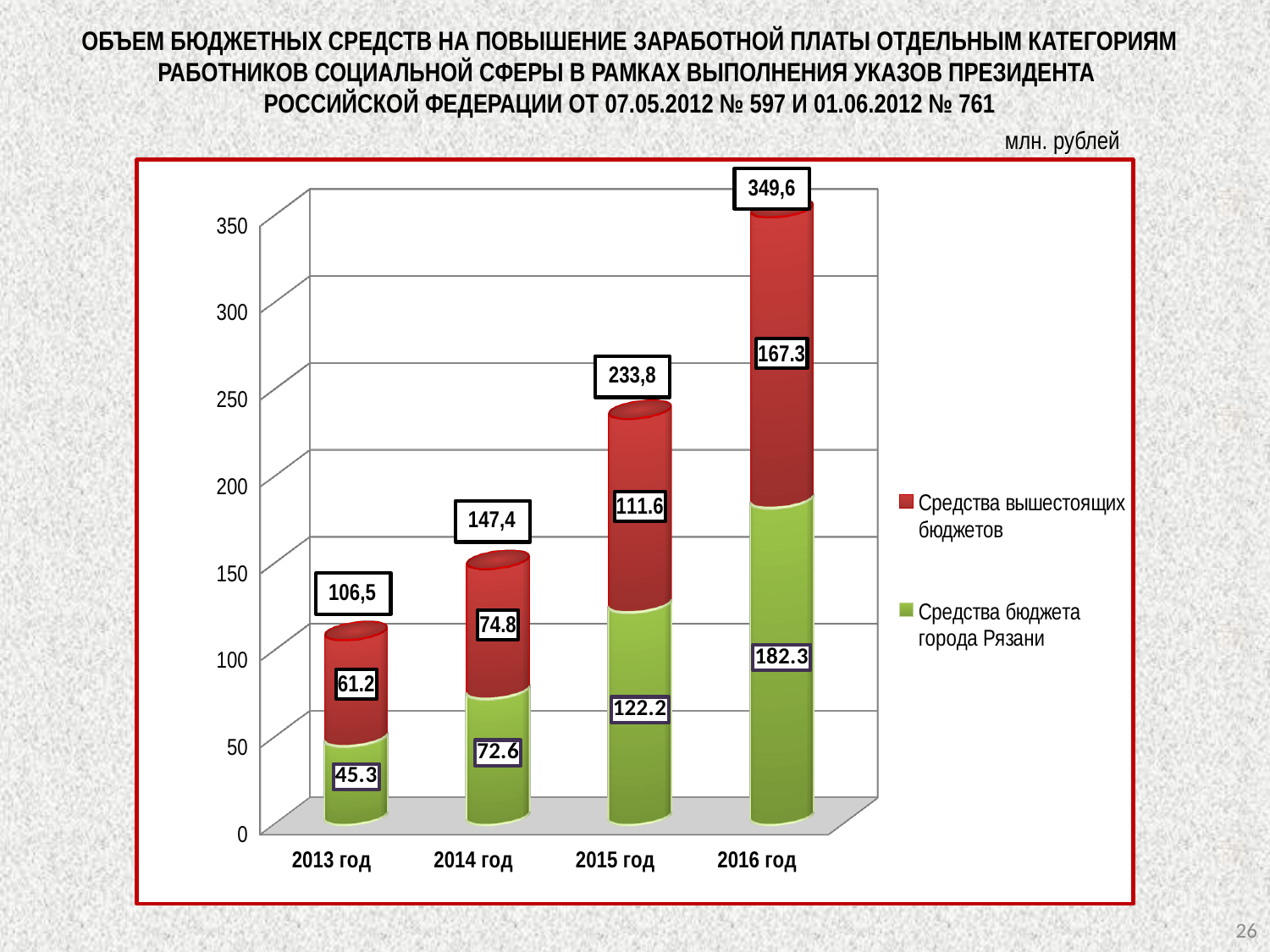
Do the total values rise or fall from 2013 год to 2016 год? Rise What is the difference between Средства вышестоящих бюджетов in 2016 год and in 2015 год? 55.7 What is the value for Средства вышестоящих бюджетов in 2015 год? 111.6 In 2014 год, which is larger: Средства вышестоящих бюджетов or Средства бюджета города Рязани? Средства вышестоящих бюджетов What is the total of the stacked bar for 2016 год? 349,6 Which year has the lowest value for Средства бюджета города Рязани? 2013 год What is the value for Средства бюджета города Рязани in 2013 год? 45.3 How many years are shown on the x axis? 4 What is the total of the stacked bar for 2014 год? 147,4 How many series does the legend list? 2 What kind of chart is shown? Stacked bar chart Which year has the highest total? 2016 год